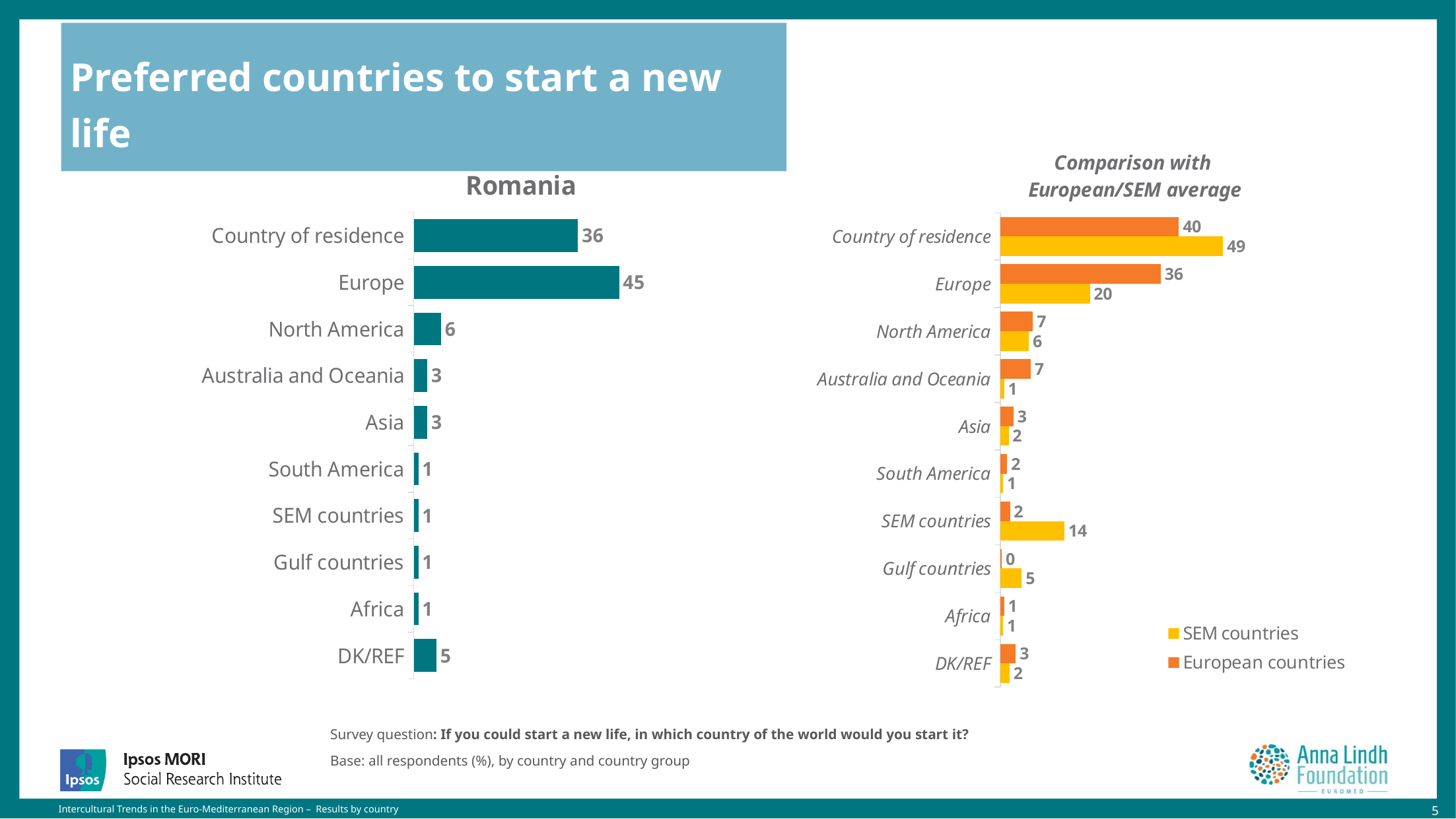
In the Comparison with European/SEM average chart, what is the difference between the SEM countries and European countries values for Europe? 16 How many series does the legend of the Comparison with European/SEM average chart list? 2 In the Comparison with European/SEM average chart, which is larger for SEM countries as a destination: the SEM countries value or the European countries value? SEM countries In the Comparison with European/SEM average chart, what is the SEM countries value for Country of residence? 49 In the Romania chart, which category has the highest value? Europe In the Romania chart, what is the difference between the values for Europe and Country of residence? 9 In the Comparison with European/SEM average chart, what is the European countries value for Europe? 36 In the Comparison with European/SEM average chart, what is the European countries value for Gulf countries? 0 In the Romania chart, what is the value for DK/REF? 5 What kind of chart is the Romania chart? Bar chart In the Romania chart, what is the value for Europe? 45 In the Romania chart, how many categories are shown? 10